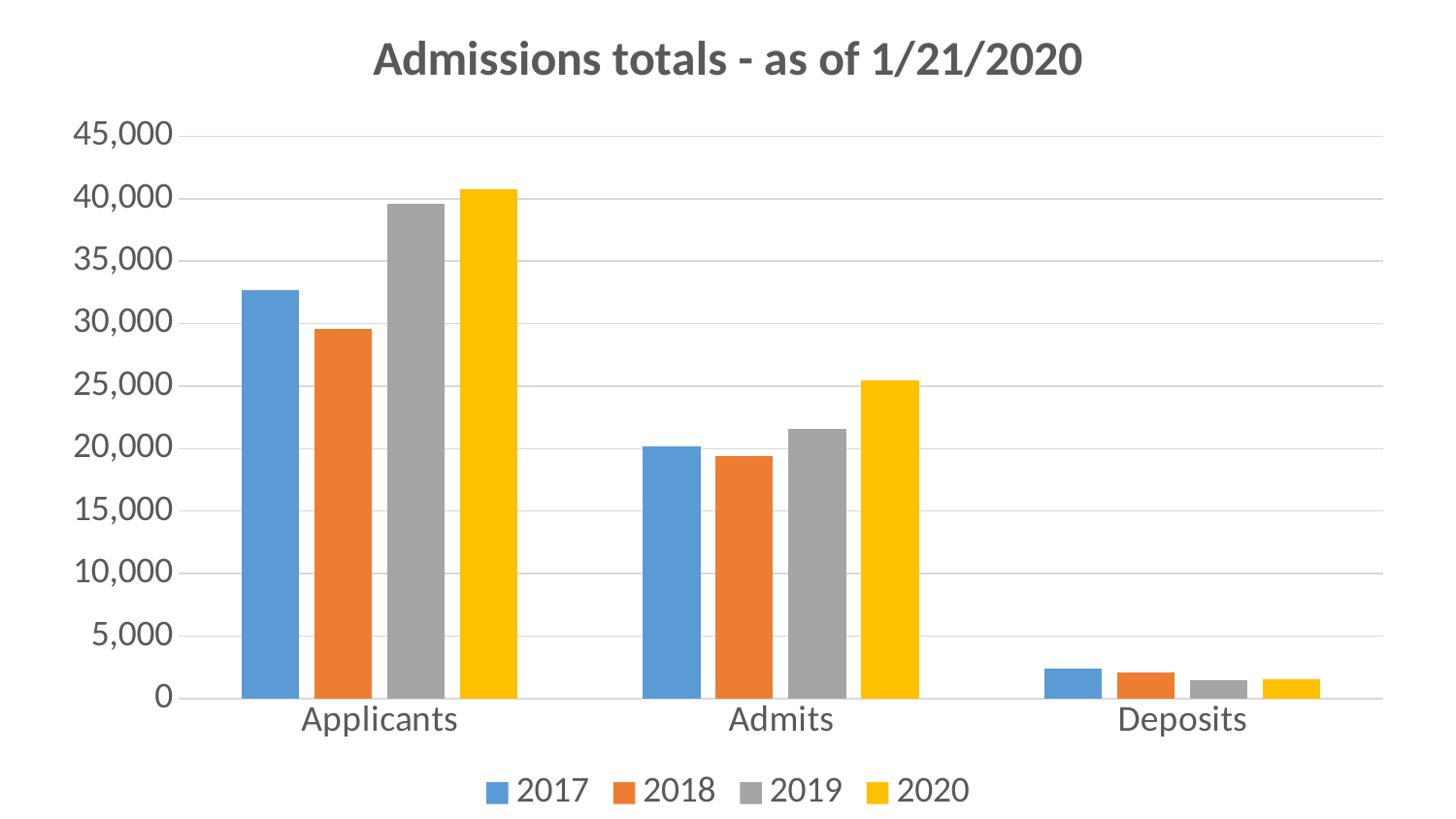
Which year has the highest number of Admits? 2020 Is the value for 2019 Applicants greater or less than 40,000? less Which year has the lowest number of Applicants? 2018 Which year has the highest number of Applicants? 2020 How many series does the legend list? 4 What type of chart is shown on the slide? bar chart Which is larger, Deposits for 2017 or Deposits for 2019? 2017 Is the value for 2017 Applicants greater or less than 30,000? greater Is the value for 2018 Admits greater or less than 20,000? less Which year has the lowest number of Admits? 2018 What is the title of the chart? Admissions totals - as of 1/21/2020 How many categories are shown on the x axis? 3